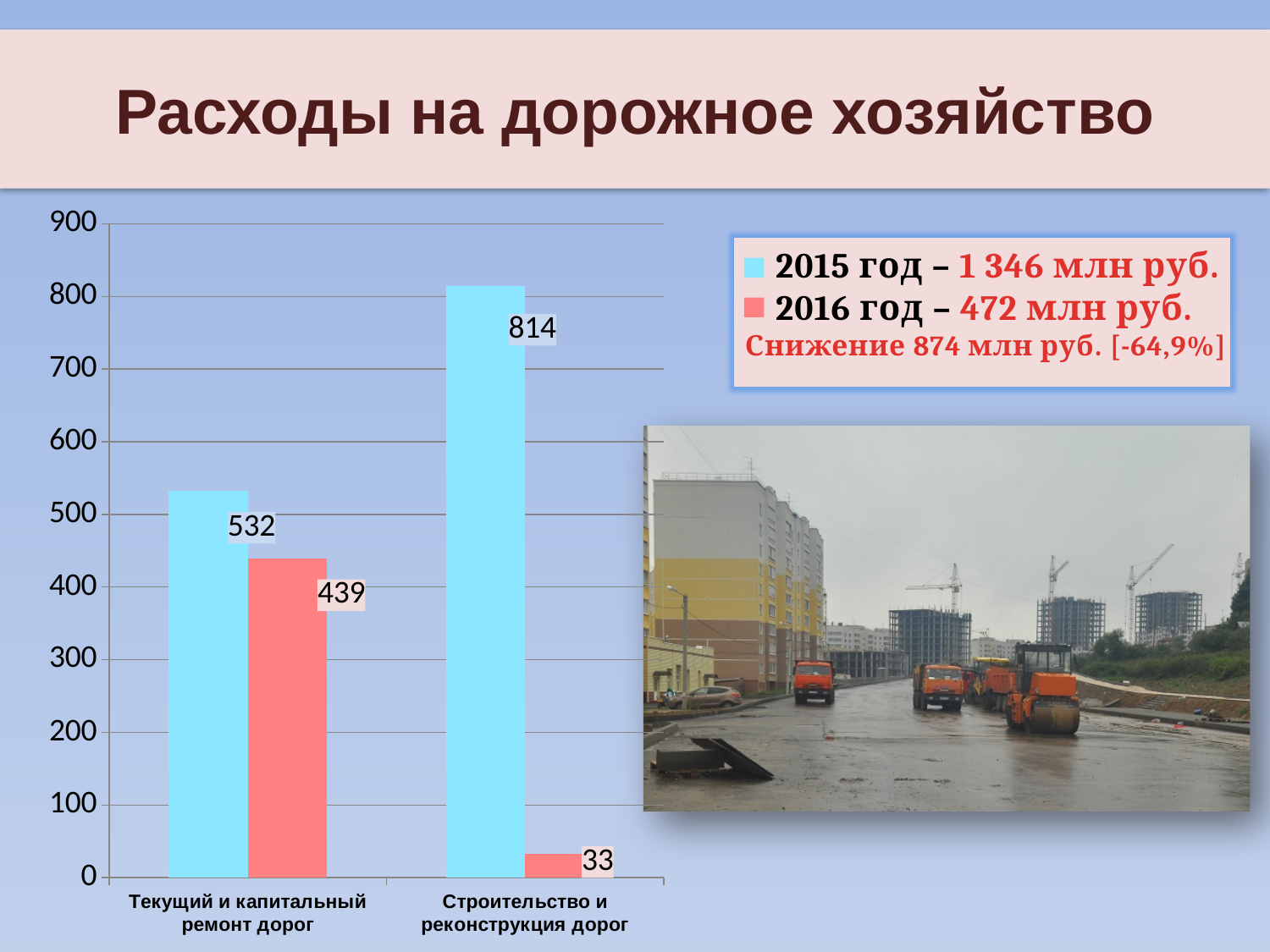
What is the 2016 value for "Текущий и капитальный ремонт дорог"? 439 Which is larger: the 2015 value for "Текущий и капитальный ремонт дорог" or the 2015 value for "Строительство и реконструкция дорог"? Строительство и реконструкция дорог How many series does the legend list? 2 What is the 2015 value for "Текущий и капитальный ремонт дорог"? 532 What is the 2015 value for "Строительство и реконструкция дорог"? 814 How many categories are shown on the x axis? 2 What is the 2016 value for "Строительство и реконструкция дорог"? 33 What is the difference between the 2015 and 2016 values for "Строительство и реконструкция дорог"? 781 What is the difference between the 2015 and 2016 values for "Текущий и капитальный ремонт дорог"? 93 Which category has the highest 2015 value? Строительство и реконструкция дорог What kind of chart is shown on the slide? Bar chart Which category has the lowest 2016 value? Строительство и реконструкция дорог